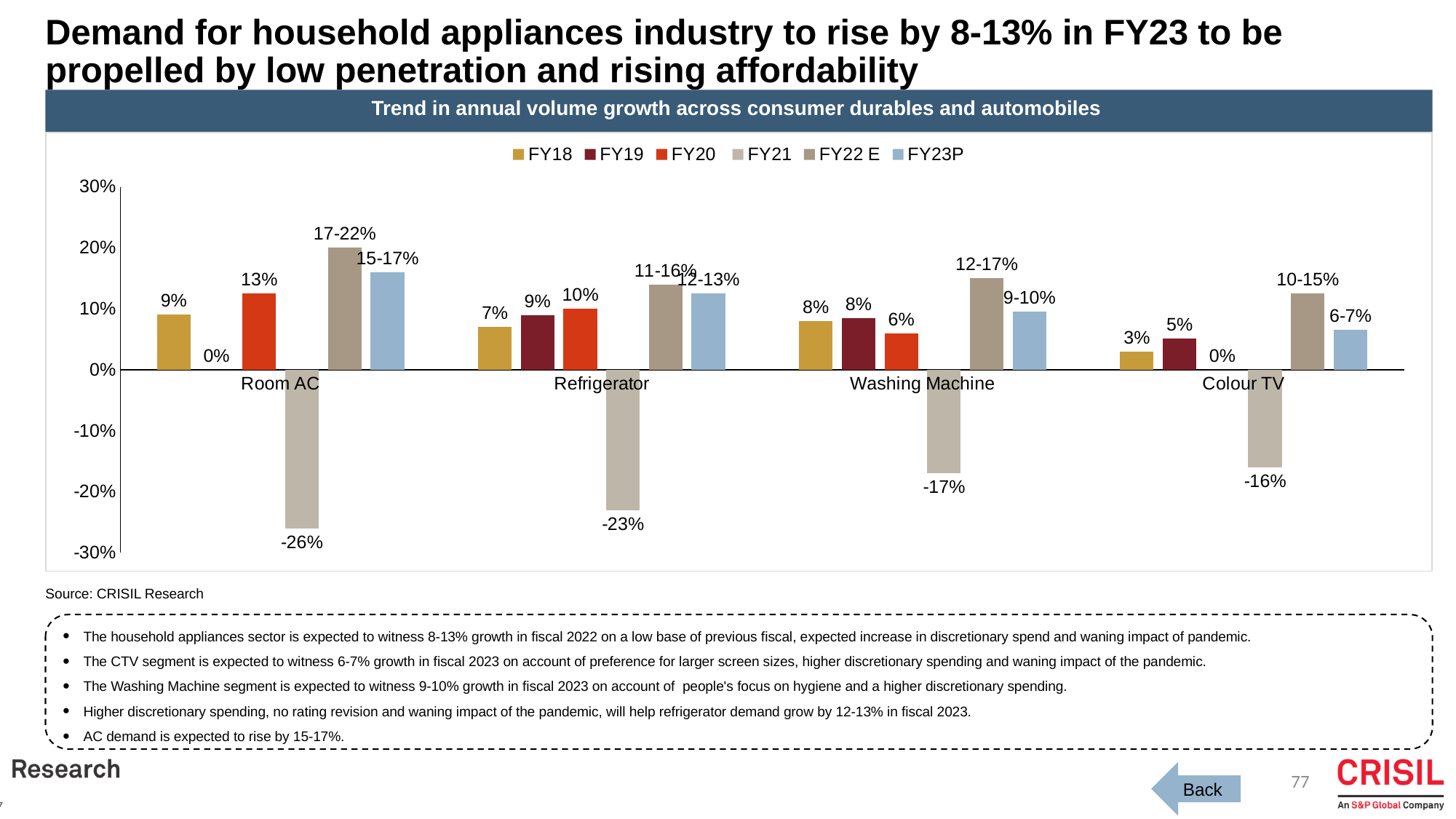
What kind of chart is shown on the slide? Bar chart What is the FY18 volume growth value for Colour TV? 3% Which is larger, the FY19 value for Refrigerator or the FY19 value for Colour TV? Refrigerator Which category has the lowest FY21 value? Room AC How many product categories are shown on the x axis? 4 What is the FY21 volume growth value for Refrigerator? -23% What is the difference between the FY20 values for Room AC and Refrigerator? 3% Which category has the highest FY18 value? Room AC What is the FY23P volume growth value for Washing Machine? 9-10% What is the FY22 E volume growth value for Colour TV? 10-15% What is the FY20 volume growth value for Room AC? 13% How many series does the legend list? 6